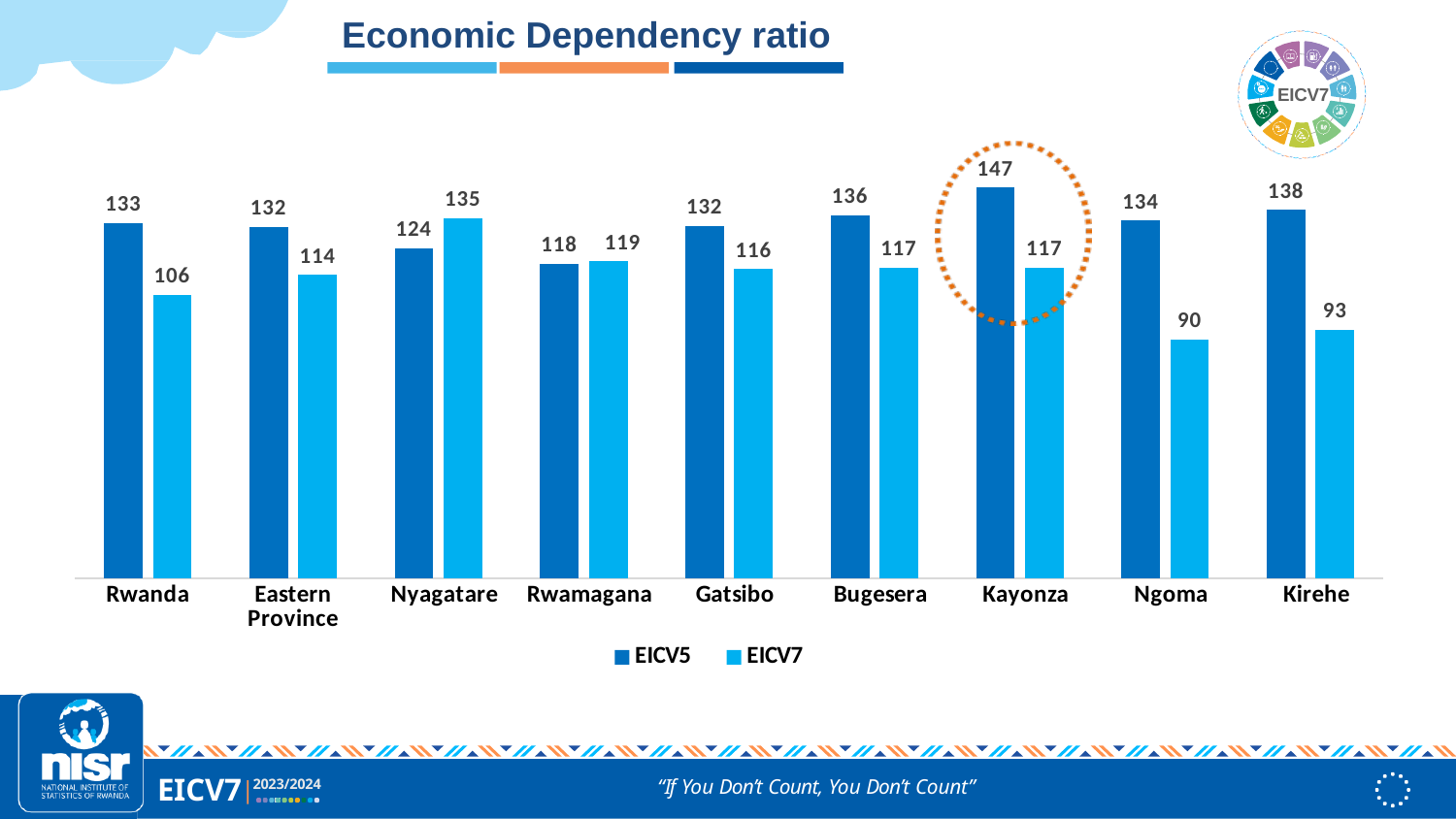
How many categories are shown on the x axis? 9 What is the EICV7 economic dependency ratio for Rwanda? 106 Which is larger for Nyagatare, the EICV5 value or the EICV7 value? EICV7 What kind of chart is shown on the slide? Bar chart What is the title of the chart? Economic Dependency ratio How many series does the legend list? 2 Which category is highlighted with a dotted orange circle? Kayonza What is the difference between the EICV5 and EICV7 values for Kirehe? 45 Which category has the lowest EICV7 value? Ngoma What is the EICV7 value for Ngoma? 90 What is the EICV5 economic dependency ratio for Kayonza? 147 Which category has the highest EICV5 value? Kayonza